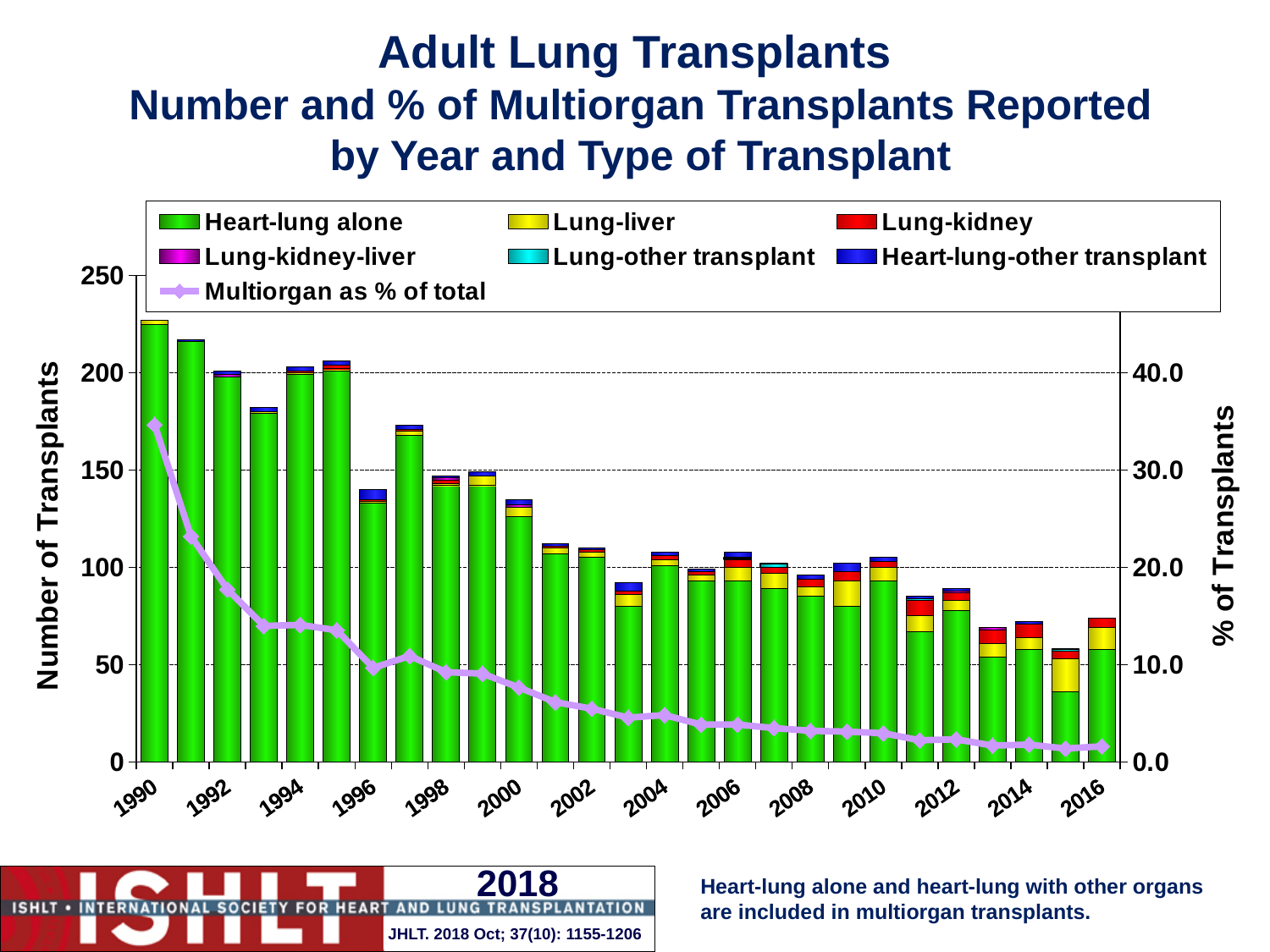
Which year has the highest total number of transplants? 1990 Which year has a larger total number of transplants, 1990 or 2016? 1990 Is the total number of transplants for 2016 greater or less than 100? less What kind of chart is shown on the slide? Stacked bar chart with a line Does the Multiorgan as % of total line generally rise or fall from 1990 to 2016? fall Which year has the lowest total number of transplants? 2015 Is the Multiorgan as % of total value for 1990 greater or less than 30.0? greater Is the Multiorgan as % of total value for 2016 greater or less than 10.0? less How many series does the legend list? 7 How many years (bars) are plotted along the x axis? 27 Which series is shown in green in the legend? Heart-lung alone